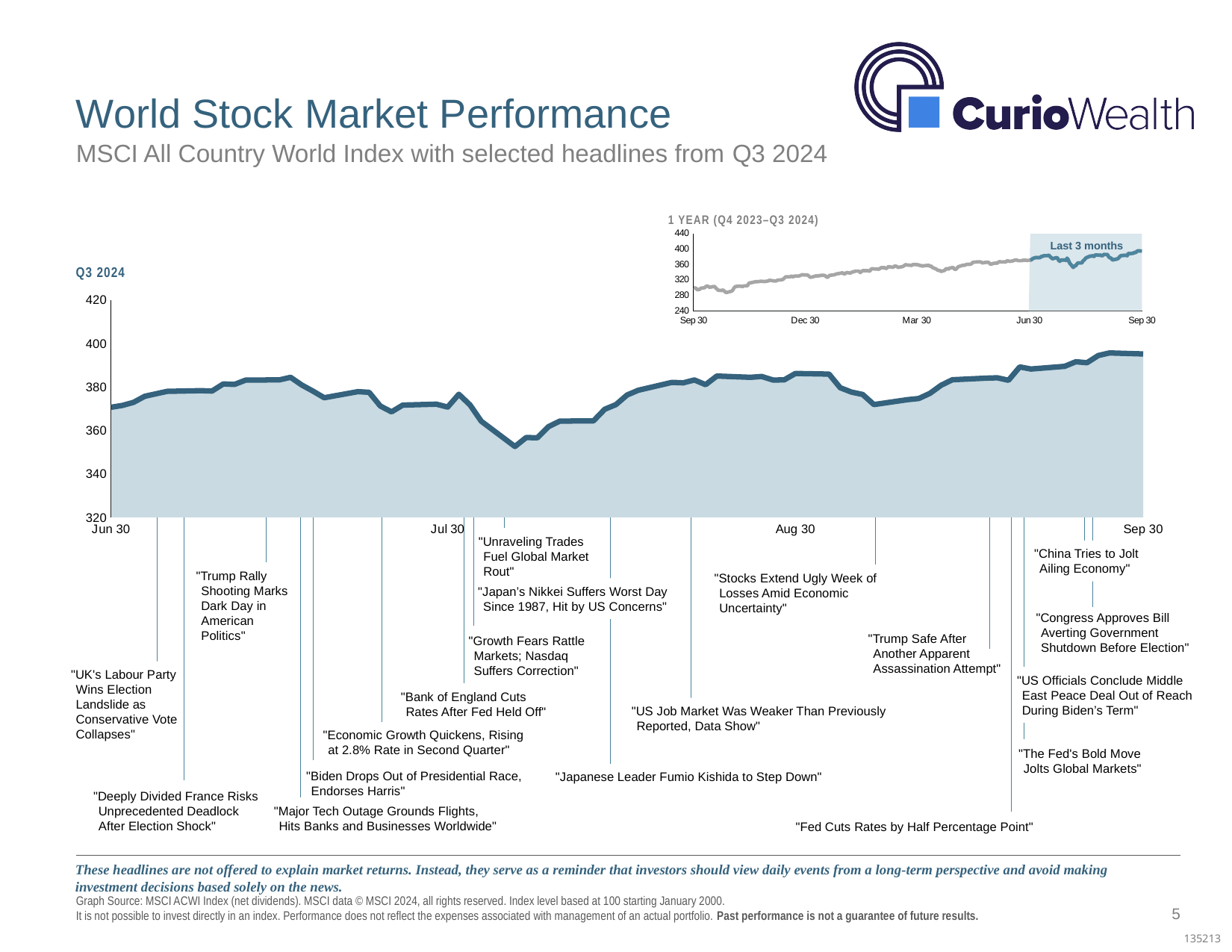
On the inset 1 YEAR (Q4 2023–Q3 2024) chart, is the value at the final Sep 30 greater or less than 360? greater On the main Q3 2024 chart, is the lowest point of the line (in early August) greater or less than 360? less What label is shown on the shaded region of the inset 1 YEAR chart? Last 3 months What is the title of the small inset chart at the top right of the slide? 1 YEAR (Q4 2023–Q3 2024) On the main Q3 2024 chart, which is larger, the value at Jun 30 or the value at Sep 30? Sep 30 On the inset 1 YEAR (Q4 2023–Q3 2024) chart, do values generally rise or fall from the first Sep 30 to the final Sep 30? rise On the main Q3 2024 chart, which of the labelled dates on the x axis has the highest index value? Sep 30 On the inset 1 YEAR (Q4 2023–Q3 2024) chart, is the value at the first Sep 30 greater or less than 320? less How many date labels are shown on the x axis of the main Q3 2024 chart? 4 What kind of chart is the main Q3 2024 chart on the slide? area chart